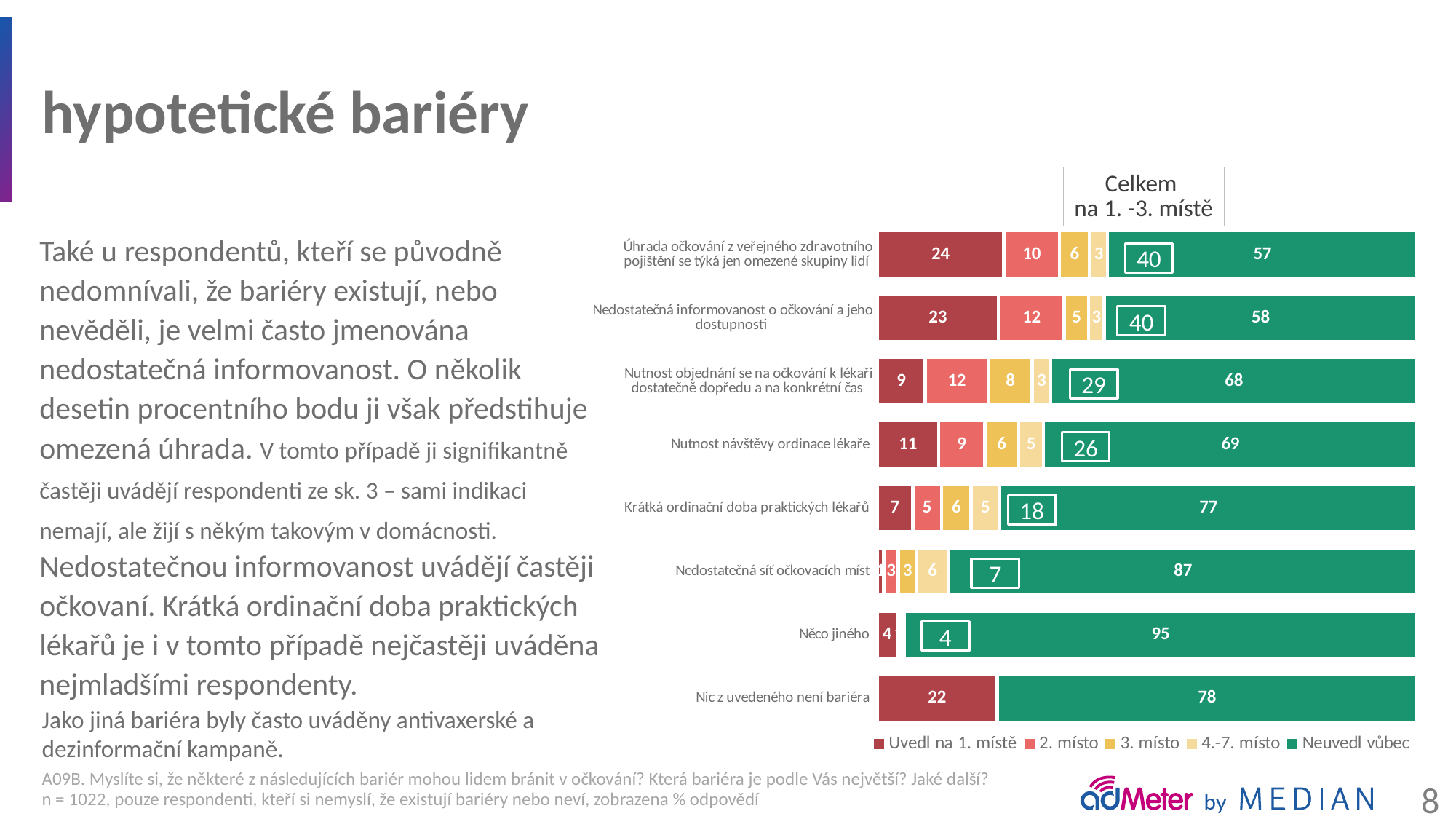
What is the value of "Uvedl na 1. místě" for "Nedostatečná informovanost o očkování a jeho dostupnosti"? 23 What is the difference between the "2. místo" values for "Nutnost objednání se na očkování k lékaři dostatečně dopředu a na konkrétní čas" and "Nutnost návštěvy ordinace lékaře"? 3 What is the total of the stacked bar for "Nic z uvedeného není bariéra"? 100 What is the value of "Neuvedl vůbec" for "Nutnost návštěvy ordinace lékaře"? 69 What is the "Celkem na 1.-3. místě" value shown for "Krátká ordinační doba praktických lékařů"? 18 Which has the larger "Uvedl na 1. místě" value: "Úhrada očkování z veřejného zdravotního pojištění se týká jen omezené skupiny lidí" or "Nic z uvedeného není bariéra"? Úhrada očkování z veřejného zdravotního pojištění se týká jen omezené skupiny lidí Which category has the lowest "Neuvedl vůbec" value? Úhrada očkování z veřejného zdravotního pojištění se týká jen omezené skupiny lidí How many series does the legend list? 5 Which category has the highest "Neuvedl vůbec" value? Něco jiného What colour represents the "Neuvedl vůbec" series? Green What type of chart is shown on the slide? Stacked bar chart How many categories (bars) does the chart show? 8